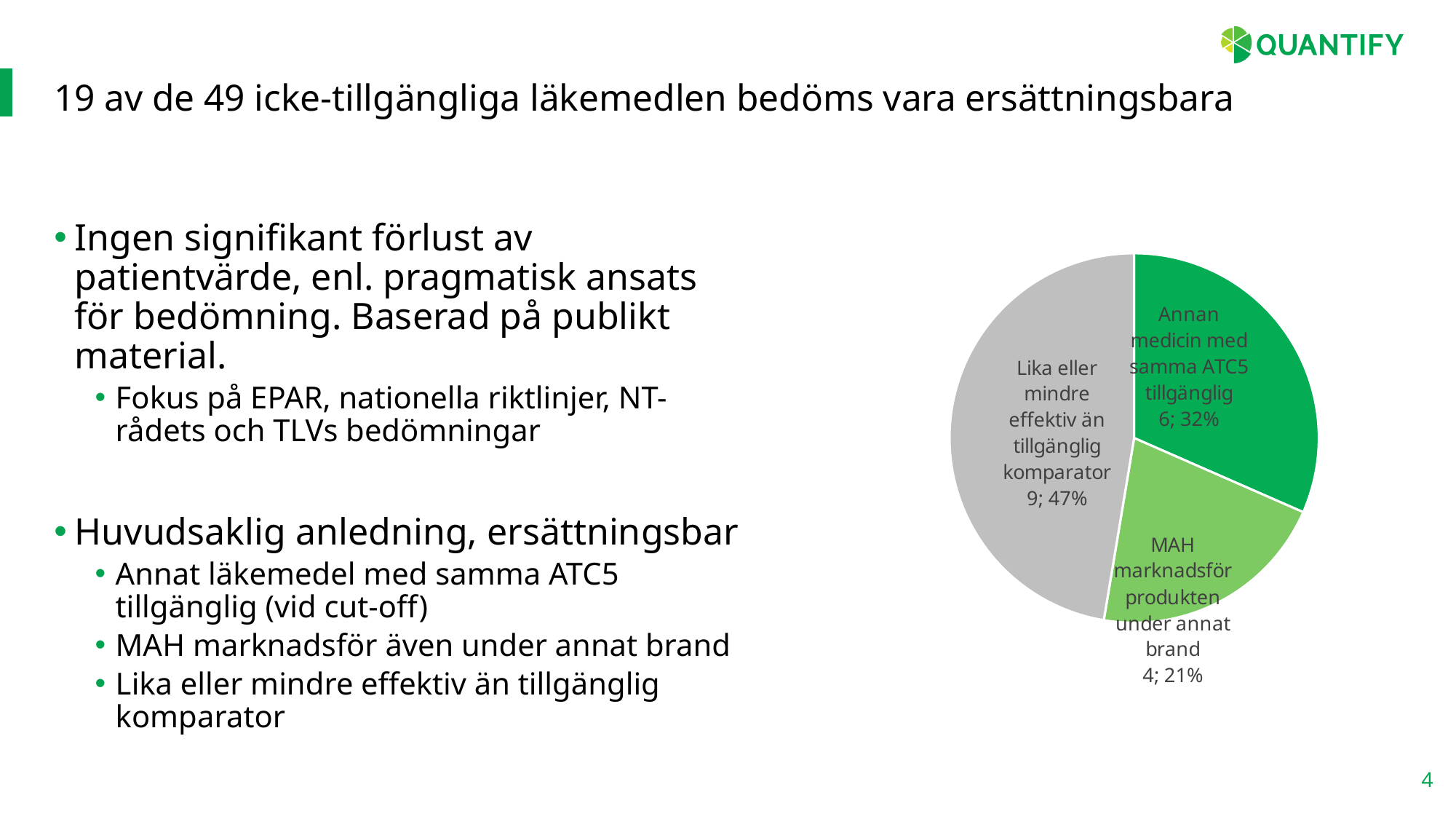
What share of the pie does 'MAH marknadsför produkten under annat brand' represent? 21% What is the count for the slice 'Annan medicin med samma ATC5 tillgänglig'? 6 How many slices does the pie chart have? 3 What is the difference in count between 'Lika eller mindre effektiv än tillgänglig komparator' and 'Annan medicin med samma ATC5 tillgänglig'? 3 What is the count for the slice 'Lika eller mindre effektiv än tillgänglig komparator'? 9 What share of the pie does 'Annan medicin med samma ATC5 tillgänglig' represent? 32% What is the count for the slice 'MAH marknadsför produkten under annat brand'? 4 What kind of chart is shown on the slide? Pie chart What share of the pie does 'Lika eller mindre effektiv än tillgänglig komparator' represent? 47% What colour is the slice for 'Lika eller mindre effektiv än tillgänglig komparator'? Grey Which slice of the pie chart is the smallest? MAH marknadsför produkten under annat brand Which slice of the pie chart is the largest? Lika eller mindre effektiv än tillgänglig komparator